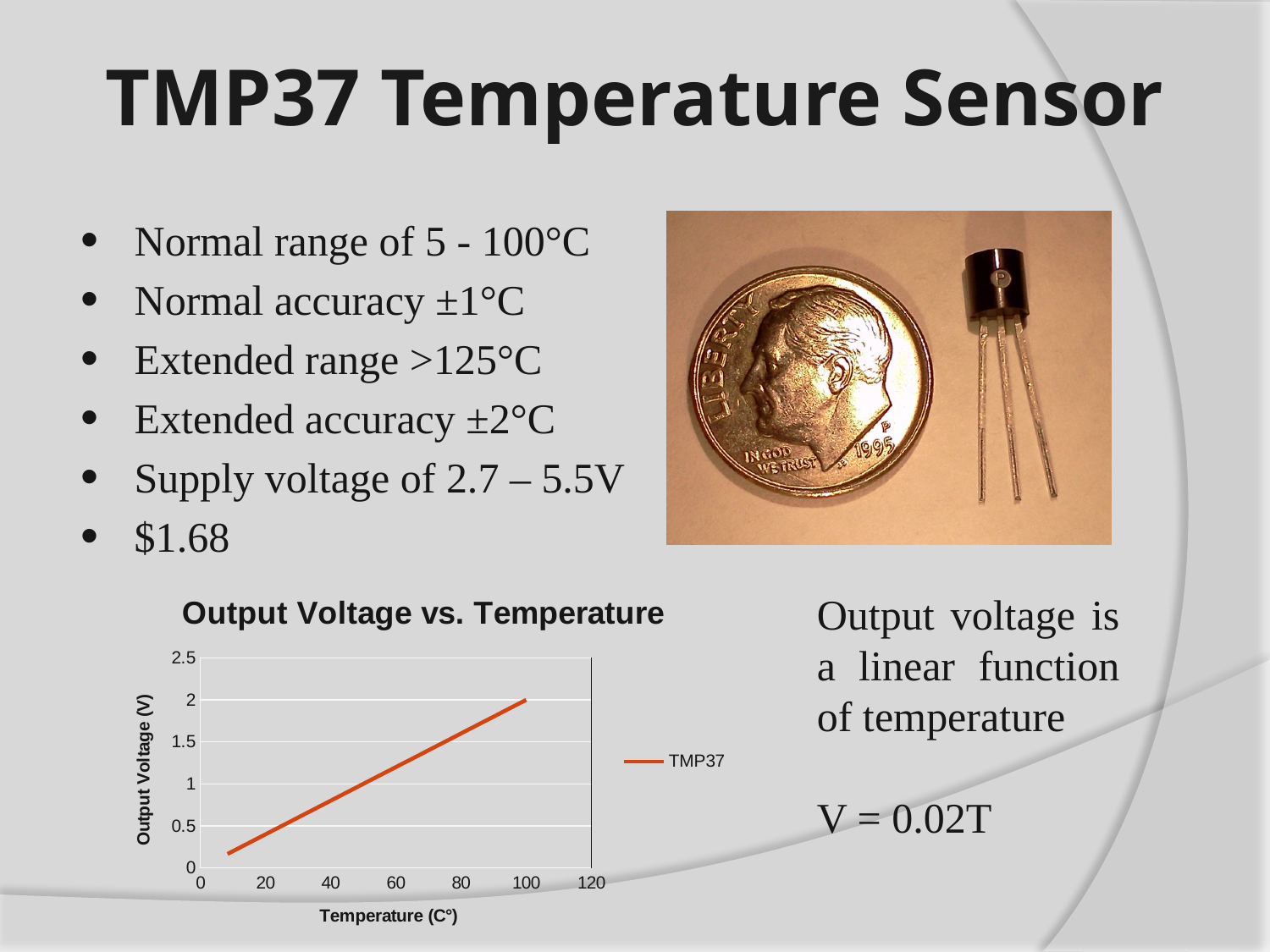
What is the name of the series shown in the chart's legend? TMP37 Is the output voltage at 40°C greater or less than 1 V? less Is the output voltage at 20°C greater or less than 0.5 V? less What is the output voltage at 100°C according to the chart? 2 What is the title of the chart on the slide? Output Voltage vs. Temperature What is the label of the chart's x axis? Temperature (C°) Is the output voltage at 60°C greater or less than 1 V? greater What kind of chart is shown on the slide? line chart Does the output voltage rise or fall as temperature increases along the x axis? rise Which is larger, the output voltage at 80°C or at 40°C? 80°C How many series does the chart's legend list? 1